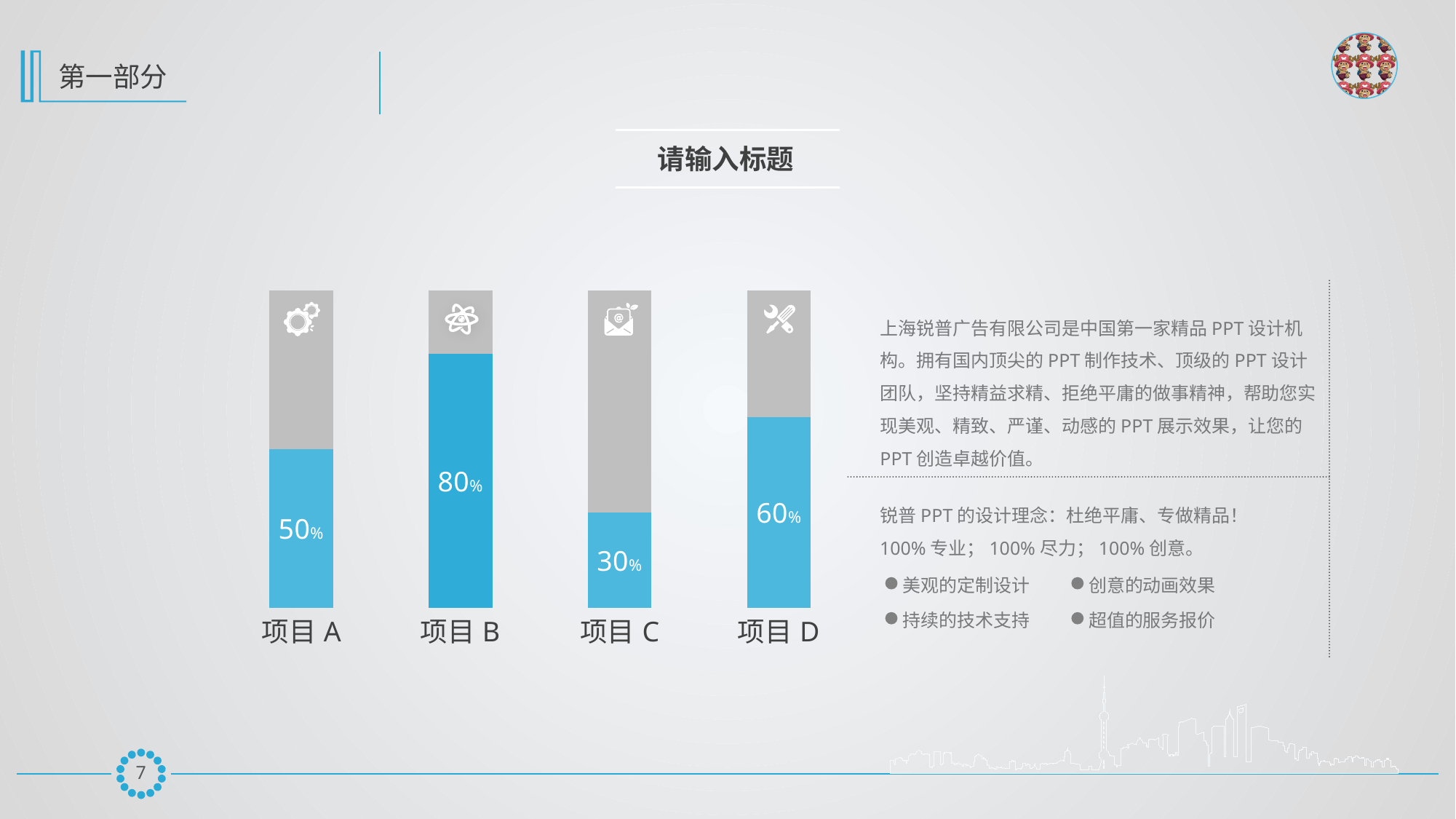
Which category has the highest value? 项目 B Which is larger, the value for 项目 A or the value for 项目 D? 项目 D What is the value for 项目 C? 30% What is the value for 项目 B? 80% Which category has the lowest value? 项目 C What is the title shown above the chart? 请输入标题 What is the difference between the values for 项目 D and 项目 A? 10% How many categories are shown in the chart? 4 What is the value for 项目 A? 50% What kind of chart is shown on the slide? bar chart What is the difference between the values for 项目 B and 项目 C? 50% What is the value for 项目 D? 60%